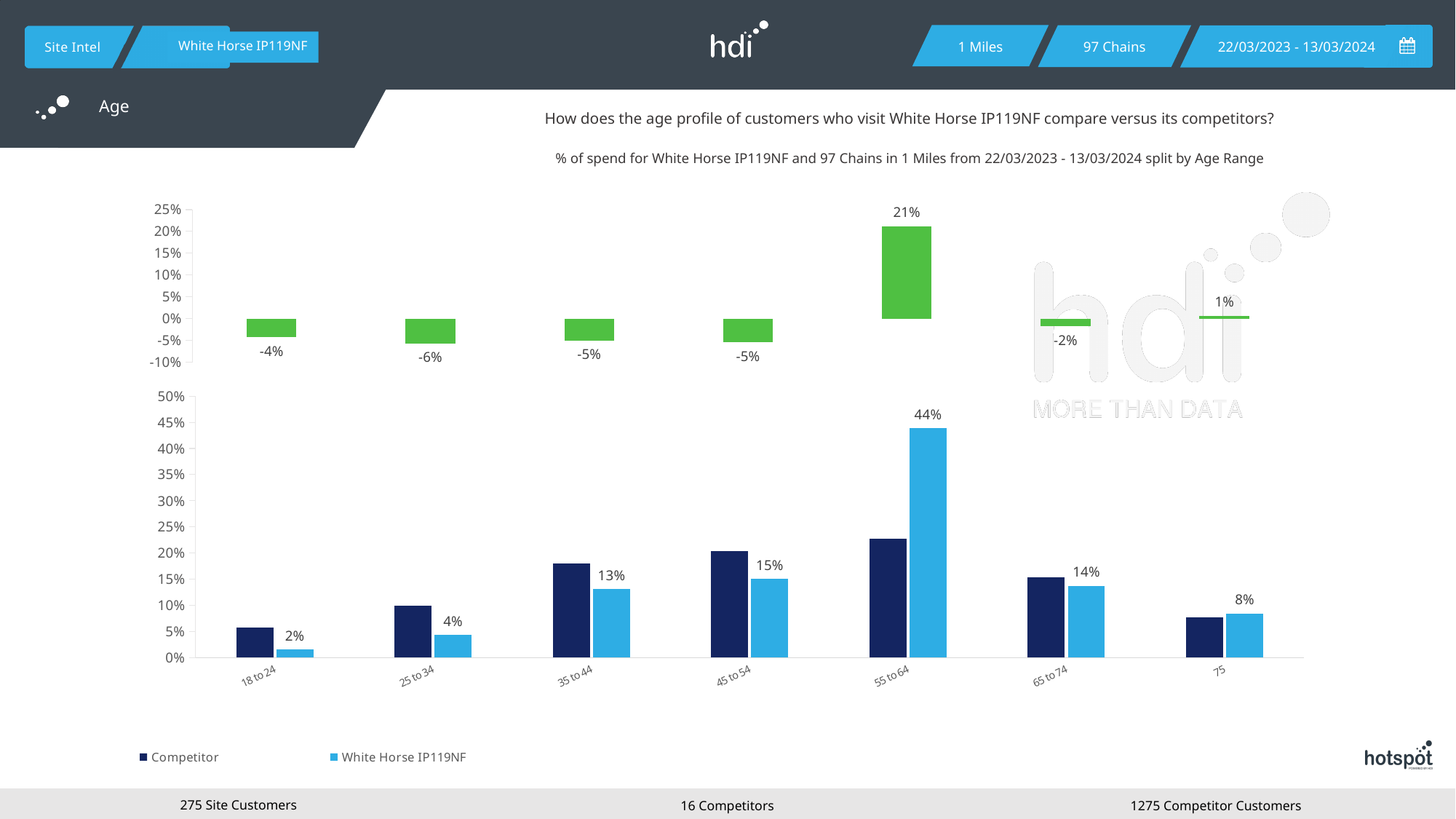
In the bottom chart, is the Competitor value for 55 to 64 greater or less than 20%? greater In the bottom chart, what is the value for White Horse IP119NF in the 55 to 64 age range? 44% In the bottom chart, what is the value for White Horse IP119NF in the 18 to 24 age range? 2% In the bottom chart, which is larger for the 25 to 34 age range, the Competitor bar or the White Horse IP119NF bar? Competitor In the bottom chart, which age range has the lowest White Horse IP119NF value? 18 to 24 In the bottom chart, which age range has the highest White Horse IP119NF value? 55 to 64 How many series does the legend of the bottom chart list? 2 How many age range categories are shown in the bottom chart? 7 In the bottom chart, what is the difference between the White Horse IP119NF values for 45 to 54 and 35 to 44? 2% In the bottom chart, is the Competitor value for 18 to 24 greater or less than 10%? less